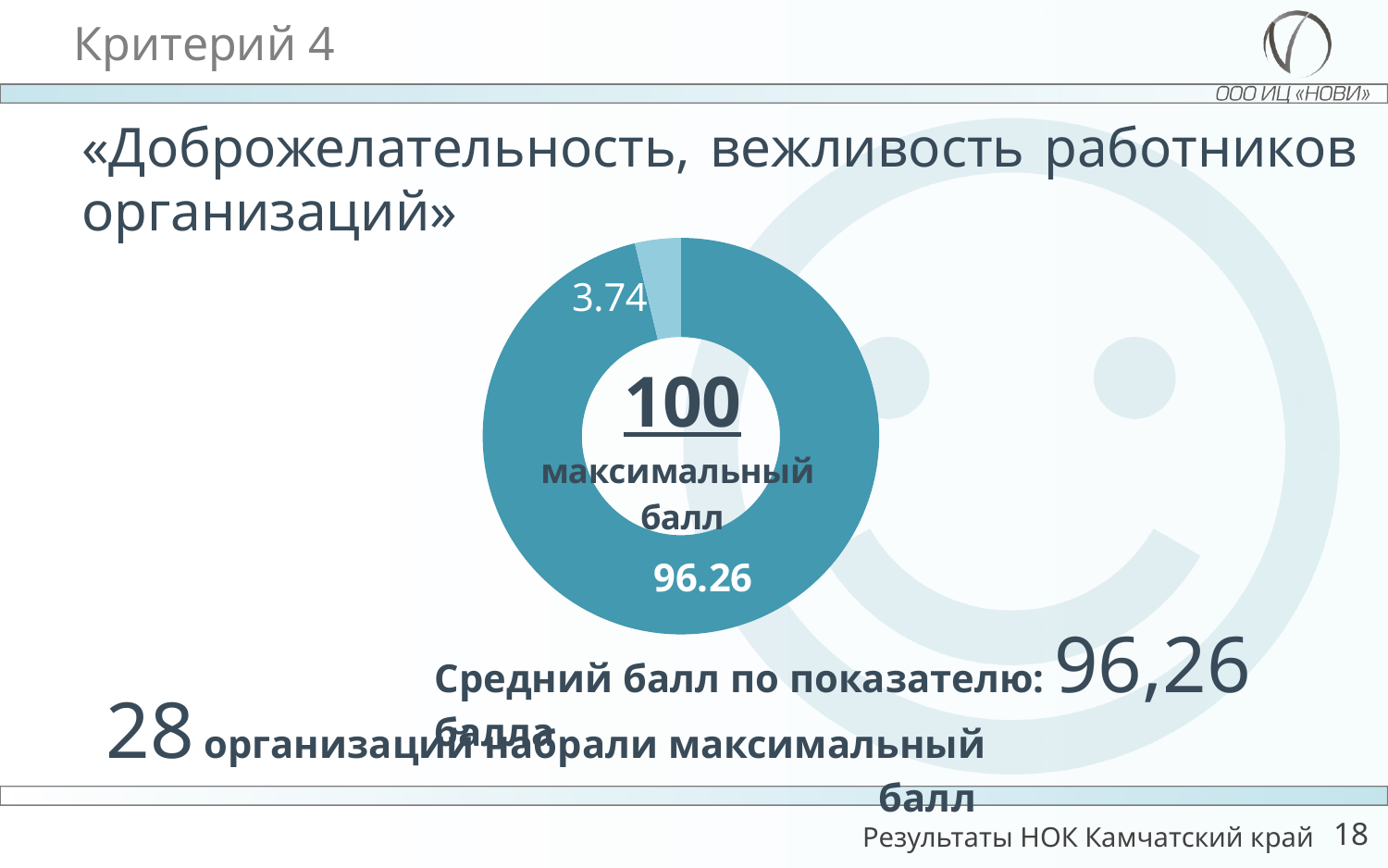
What value is labelled on the small light teal slice of the doughnut chart? 3.74 What number is printed in the centre of the doughnut chart? 100 What is the value of the smallest slice in the doughnut chart? 3.74 How many slices does the doughnut chart have? 2 What is the difference between the two slice values in the doughnut chart (96.26 and 3.74)? 92.52 What share of the whole doughnut does the slice labelled 3.74 represent? 3.74% What text appears below the number 100 in the centre of the doughnut chart? максимальный балл What value is labelled on the large dark teal slice of the doughnut chart? 96.26 Which slice is larger in the doughnut chart, the one labelled 96.26 or the one labelled 3.74? 96.26 What is the value of the largest slice in the doughnut chart? 96.26 What kind of chart is shown on the slide? Doughnut (pie) chart What is the total of the two slice values in the doughnut chart? 100